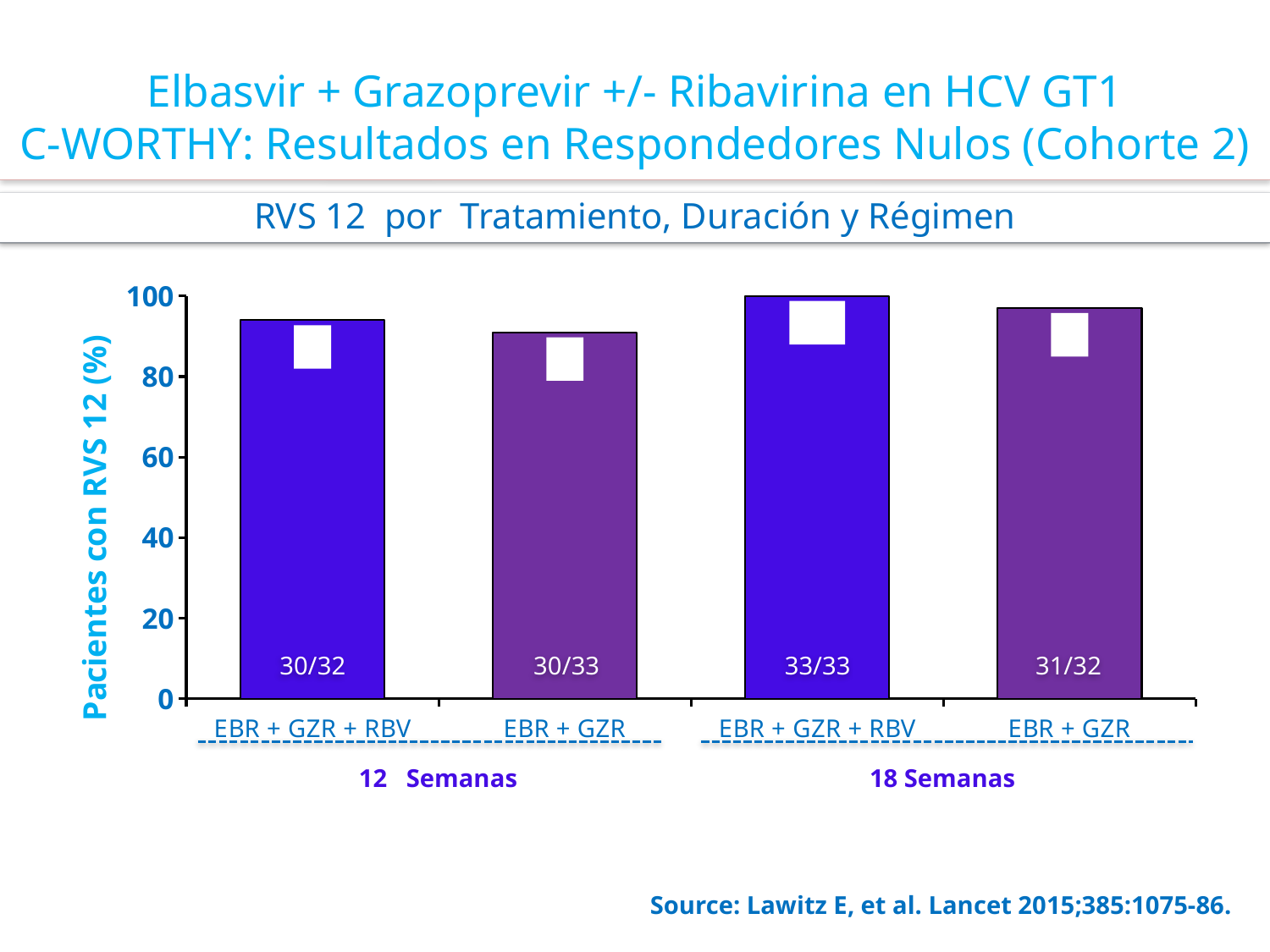
Which bar reaches the highest value on the chart? EBR + GZR + RBV at 18 Semanas What kind of chart is shown on the slide? Bar chart What is the data label printed on the bar for EBR + GZR at 12 Semanas? 30/33 Which is larger: the bar for EBR + GZR + RBV at 18 Semanas or the bar for EBR + GZR at 12 Semanas? EBR + GZR + RBV at 18 Semanas What is the data label printed on the bar for EBR + GZR + RBV at 12 Semanas? 30/32 Is the value for EBR + GZR at 12 Semanas greater or less than 80? greater What is the label of the vertical axis? Pacientes con RVS 12 (%) What is the data label printed on the bar for EBR + GZR at 18 Semanas? 31/32 What is the data label printed on the bar for EBR + GZR + RBV at 18 Semanas? 33/33 Is the value for EBR + GZR at 18 Semanas greater or less than 80? greater How many bars are plotted on the chart? 4 What are the two treatment duration groups shown below the x axis? 12 Semanas and 18 Semanas